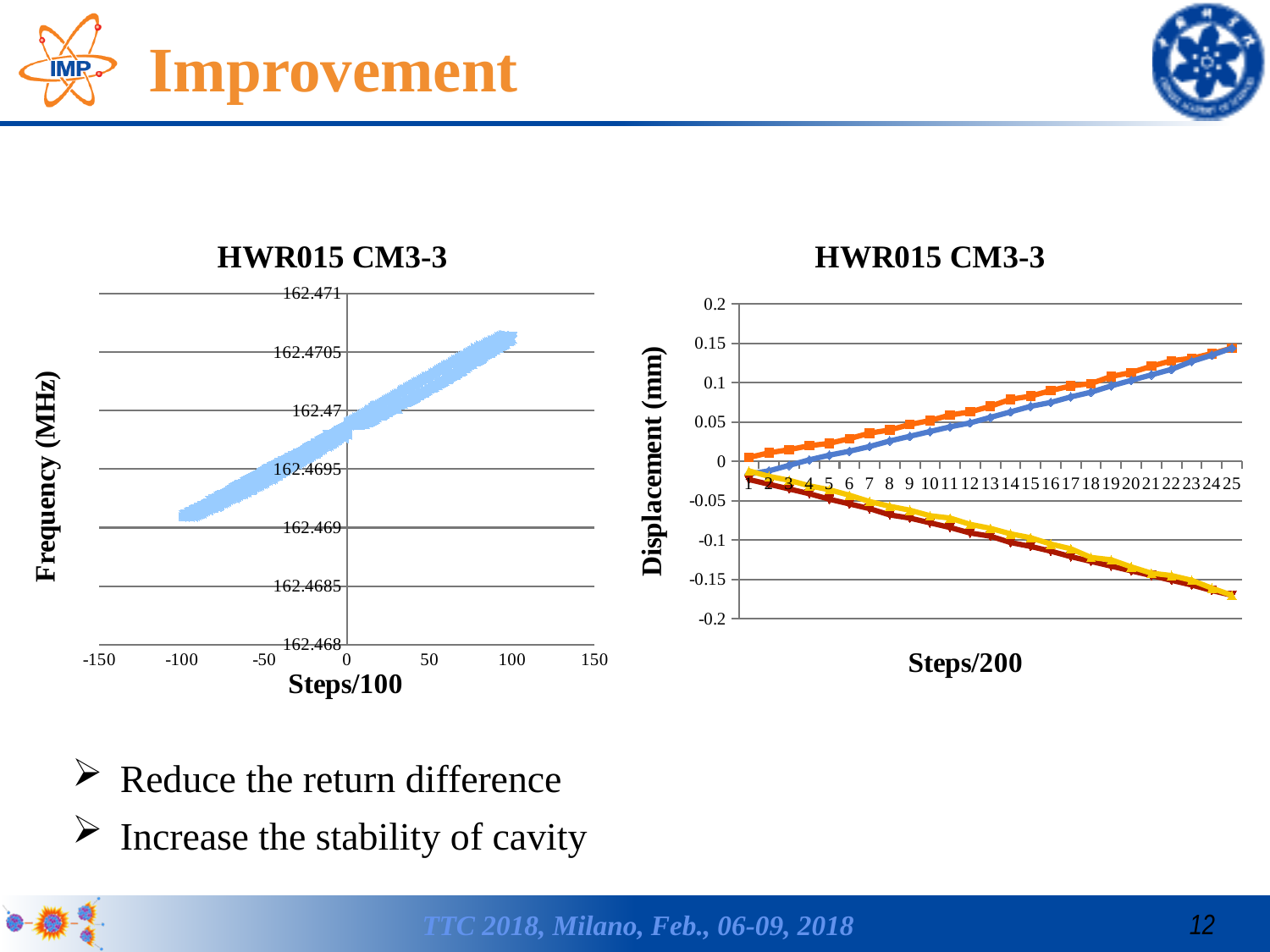
On the right chart, does the dark red line rise or fall from step 1 to step 25? fall What is the title of the chart on the left of the slide? HWR015 CM3-3 On the right chart, does the blue line rise or fall from step 1 to step 25? rise On the left chart, what is the label of the vertical axis? Frequency (MHz) On the left chart, is the frequency at Steps/100 = 100 greater or less than 162.47? greater On the right chart, is the displacement of the yellow line at step 25 greater or less than -0.15? less On the right chart, is the displacement of the blue line at step 25 greater or less than 0.1? greater On the right chart, at step 25, which line has the larger displacement: the orange line or the yellow line? orange line On the right chart, how many lines are plotted? 4 On the left chart, do the plotted values rise or fall as Steps/100 increases from -100 to 100? rise On the right chart, how many points are labelled along the horizontal axis? 25